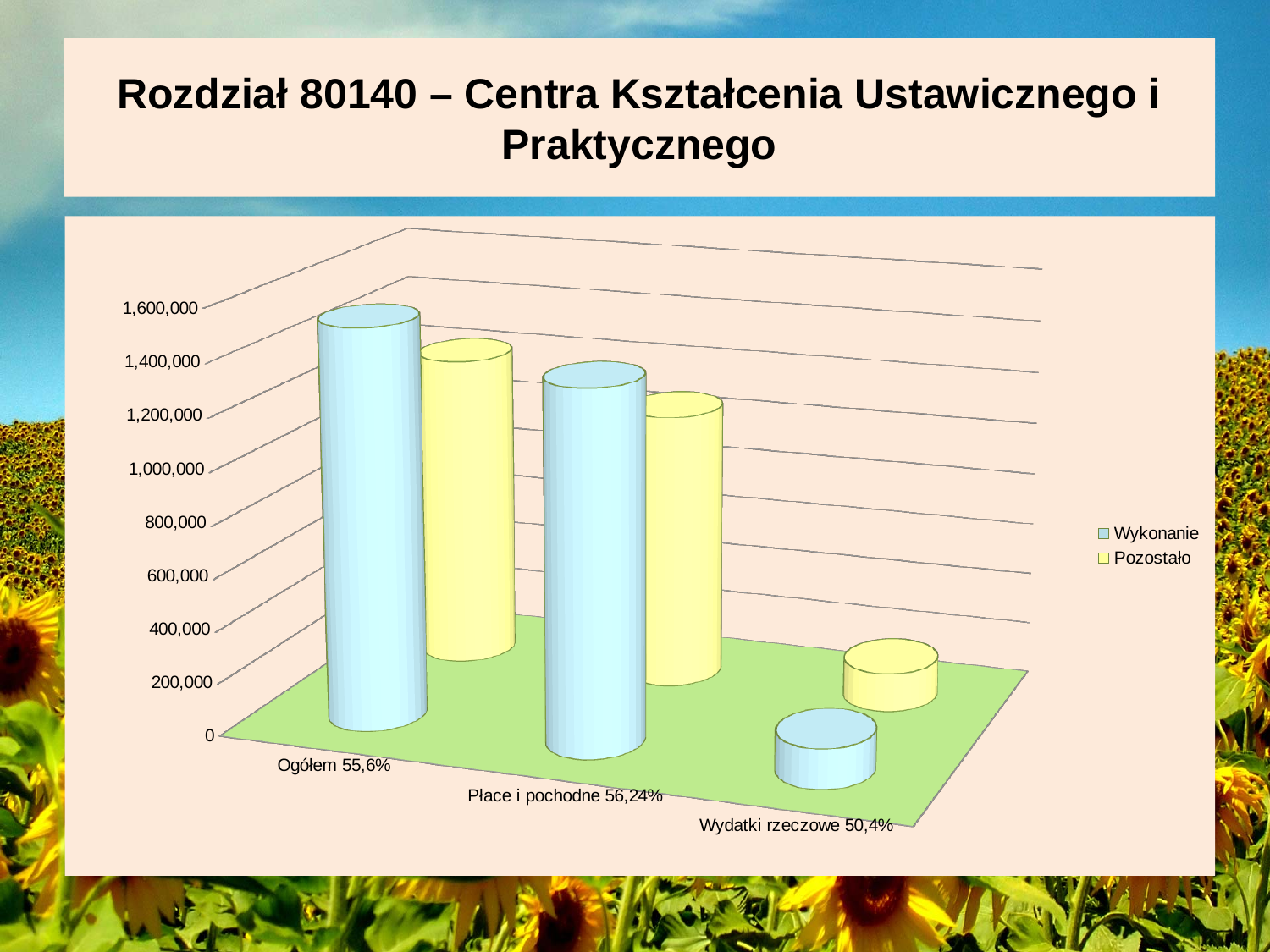
How many categories are shown on the x axis of the chart? 3 Is the Pozostało value for Płace i pochodne 56,24% greater or less than 600,000? greater What are the two series named in the chart legend? Wykonanie and Pozostało Which category has the lowest Pozostało value? Wydatki rzeczowe 50,4% Which category has the highest Wykonanie value? Ogółem 55,6% Is the Wykonanie value for Wydatki rzeczowe 50,4% greater or less than 400,000? less How many series does the chart legend list? 2 Which colour represents the Wykonanie series in the chart? blue Which category has the lowest Wykonanie value? Wydatki rzeczowe 50,4% Is the Wykonanie value for Ogółem 55,6% greater or less than 1,000,000? greater What kind of chart is shown on the slide? bar chart For Ogółem 55,6%, which is larger: Wykonanie or Pozostało? Wykonanie